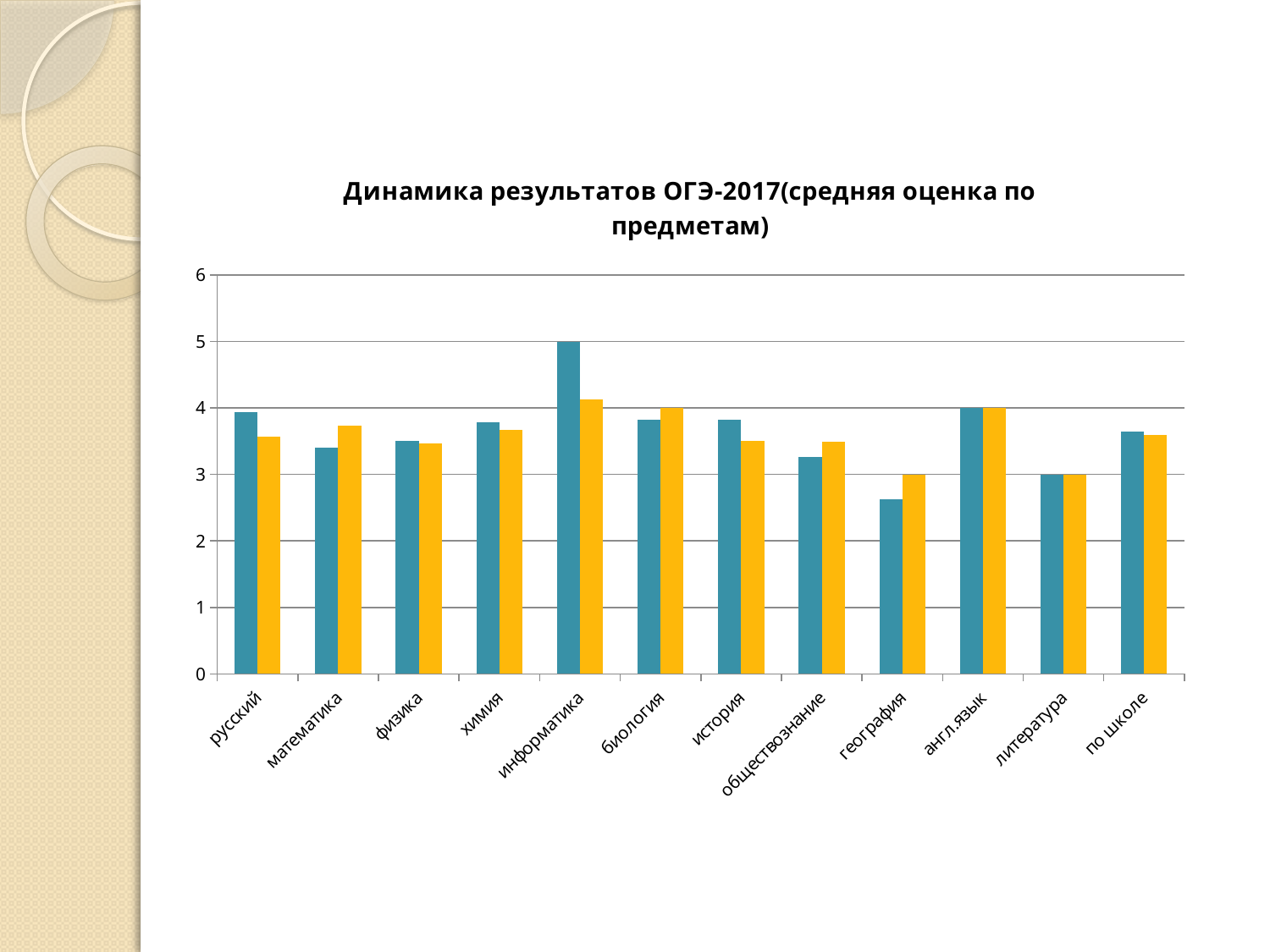
Is the blue bar for информатика greater or less than 4? greater Is the blue bar for география greater or less than 3? less How many subject categories are shown along the x axis? 12 How many data series (bar colours) are plotted for each category? 2 Which category has the highest yellow bar? информатика For математика, which bar is taller, the blue one or the yellow one? yellow What kind of chart is shown on the slide? bar chart What is the title of the chart? Динамика результатов ОГЭ-2017(средняя оценка по предметам) Which category has the lowest blue bar? география Is the yellow bar for информатика greater or less than 4? greater For русский, which bar is taller, the blue one or the yellow one? blue Which category has the highest blue bar? информатика